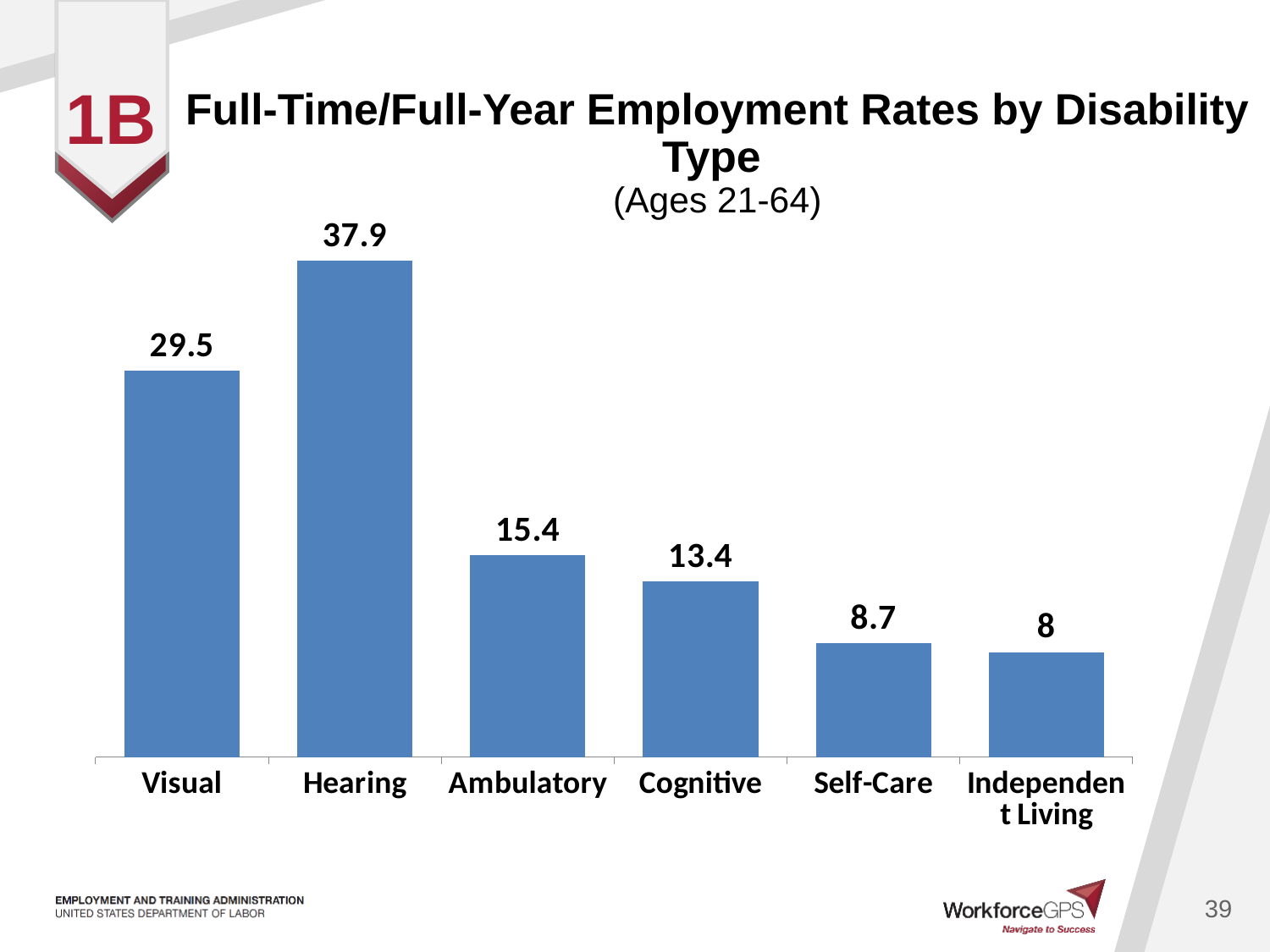
What kind of chart is shown on the slide? Bar chart What is the value shown for Visual? 29.5 Which disability type has the highest employment rate? Hearing What is the full-time/full-year employment rate for the Hearing disability type? 37.9 What age range is given in the chart's subtitle? Ages 21-64 What is the difference between the values for Hearing and Visual? 8.4 What is the value shown for Independent Living? 8 What is the value shown for Cognitive? 13.4 How many disability types are shown on the chart? 6 What is the difference between the values for Ambulatory and Cognitive? 2 Which has a larger value, Ambulatory or Self-Care? Ambulatory Which disability type has the lowest employment rate? Independent Living